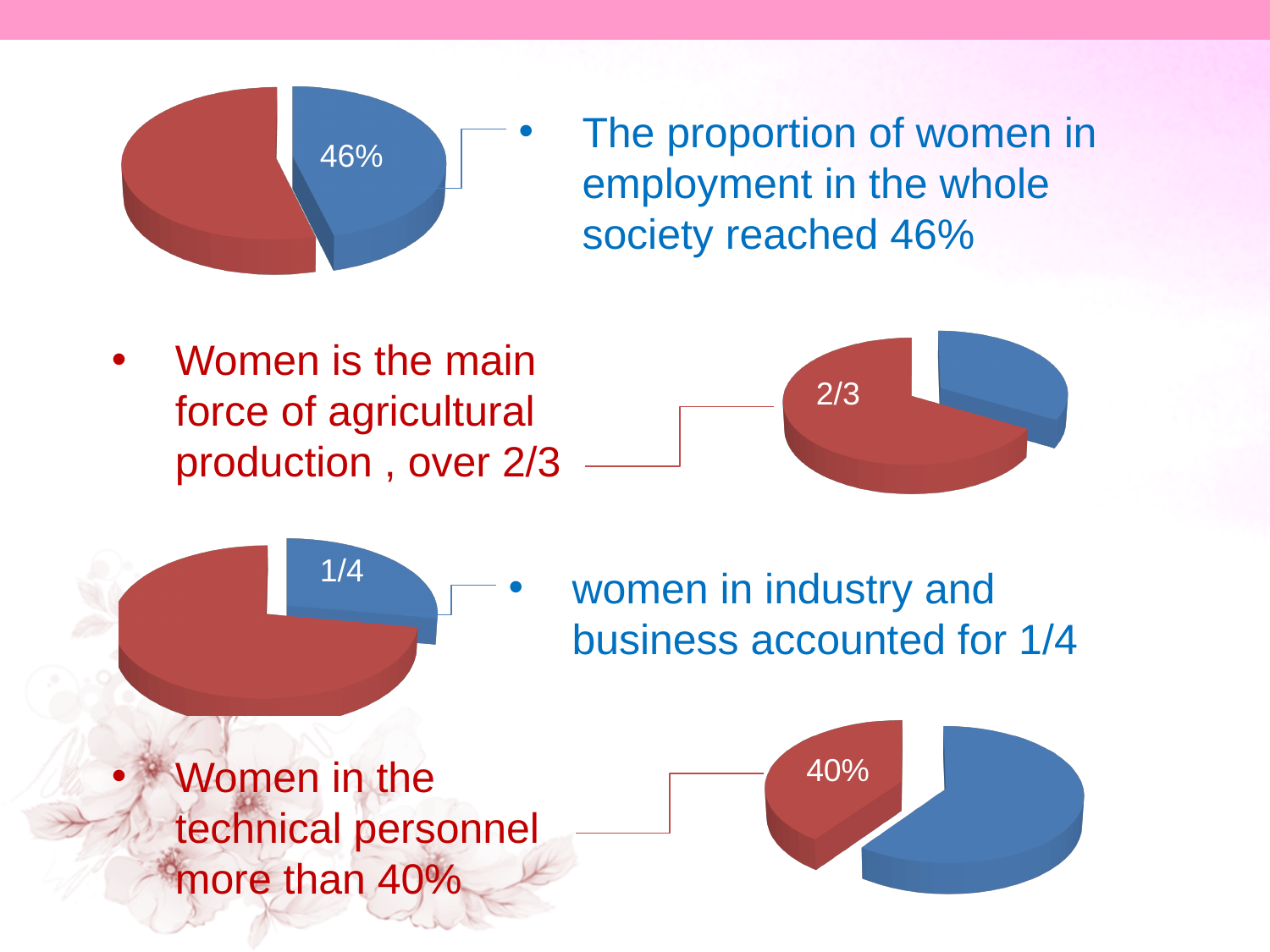
In the bottom-right pie chart, which slice is larger, the red one or the blue one? blue In the bottom-right pie chart, what value is printed on the red slice? 40% In the bottom-left pie chart, what value is printed on the blue slice? 1/4 What kind of chart is the top-left chart on the slide? pie chart In the top-left pie chart, what value is printed on the blue slice? 46% How many slices does the top-left pie chart have? 2 In the top-left pie chart, which slice is larger, the blue one or the red one? red In the middle-right pie chart, which slice is larger, the red one or the blue one? red How many pie charts are shown on the slide? 4 In the bottom-right pie chart, what share of the pie does the red slice represent according to its label? 40% In the pie chart in the middle-right of the slide, what value is printed on the red slice? 2/3